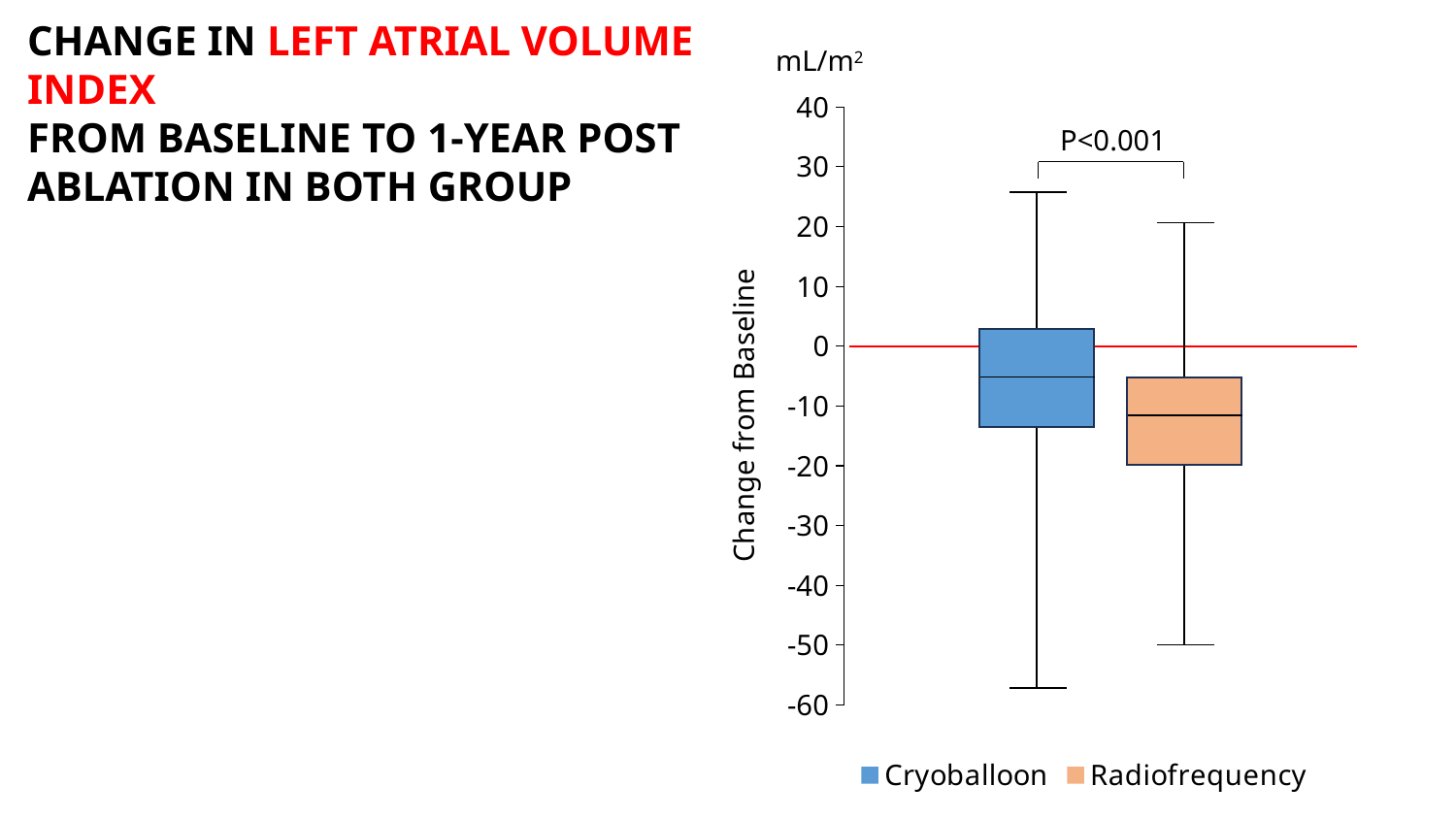
Is the upper whisker of the Cryoballoon box greater or less than 20? greater Is the top of the Radiofrequency box greater or less than 0? less What p-value is annotated between the two boxes? P<0.001 Is the bottom of the Radiofrequency box greater or less than -10? less What unit is shown above the y axis of the chart? mL/m² How many boxes are plotted in the chart? 2 What kind of chart is shown on the slide? Box-and-whisker plot Which group has the lower median change from baseline, Cryoballoon or Radiofrequency? Radiofrequency Which group's lower whisker extends further below zero, Cryoballoon or Radiofrequency? Cryoballoon How many groups does the legend list? 2